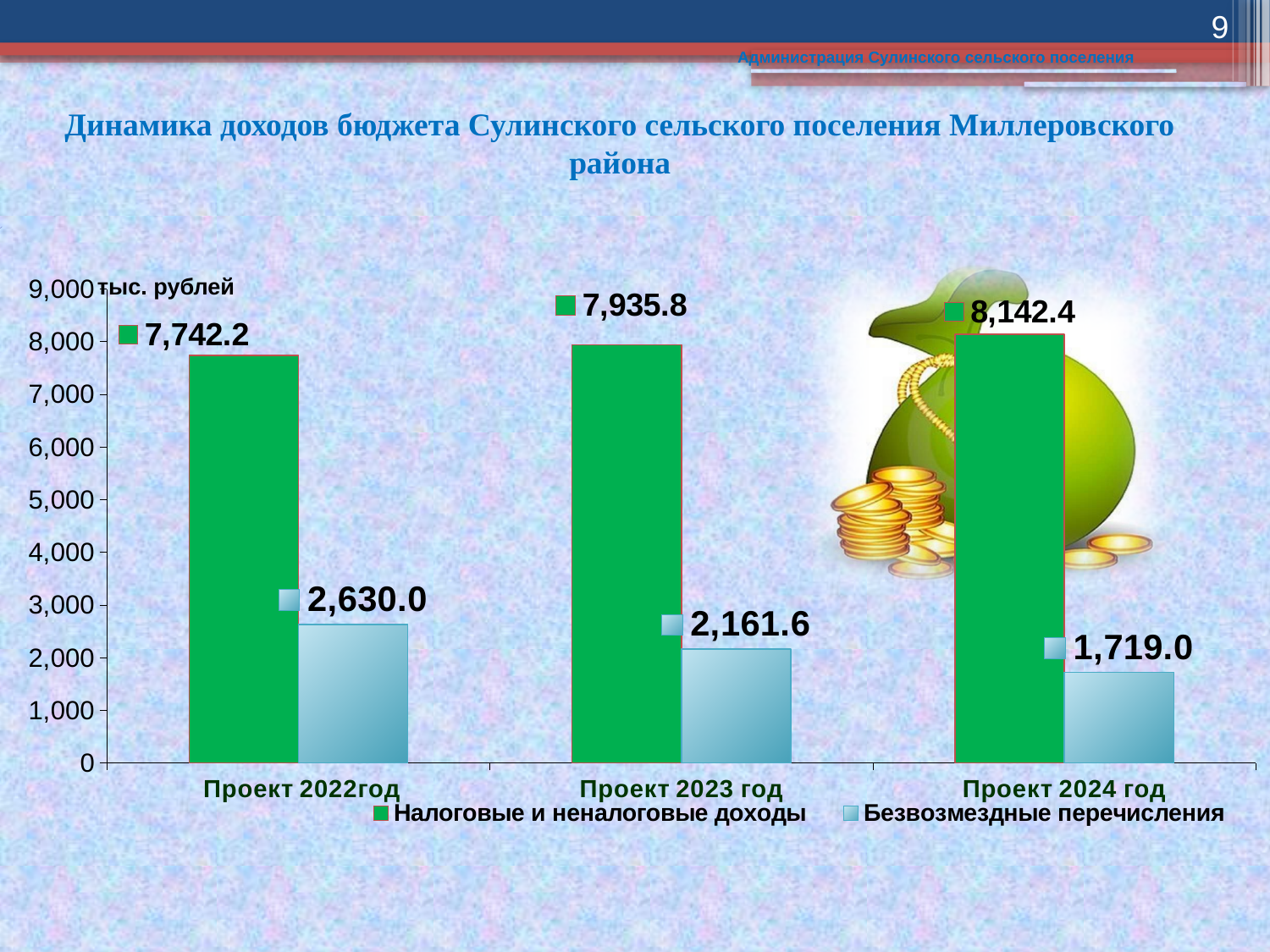
How many categories are shown on the x axis? 3 What kind of chart is shown on the slide? Bar chart What is the value of Безвозмездные перечисления for Проект 2024 год? 1,719.0 What is the value of Налоговые и неналоговые доходы for Проект 2023 год? 7,935.8 Do the values for Безвозмездные перечисления rise or fall from Проект 2022год to Проект 2024 год? Fall What is the value of Безвозмездные перечисления for Проект 2022год? 2,630.0 Which category has the lowest value for Безвозмездные перечисления? Проект 2024 год Which category has the highest value for Налоговые и неналоговые доходы? Проект 2024 год How many series does the legend list? 2 What unit is indicated at the top of the vertical axis? тыс. рублей What is the difference between Налоговые и неналоговые доходы for Проект 2024 год and Проект 2022год? 400.2 Which is larger: Безвозмездные перечисления for Проект 2022год or for Проект 2023 год? Проект 2022год